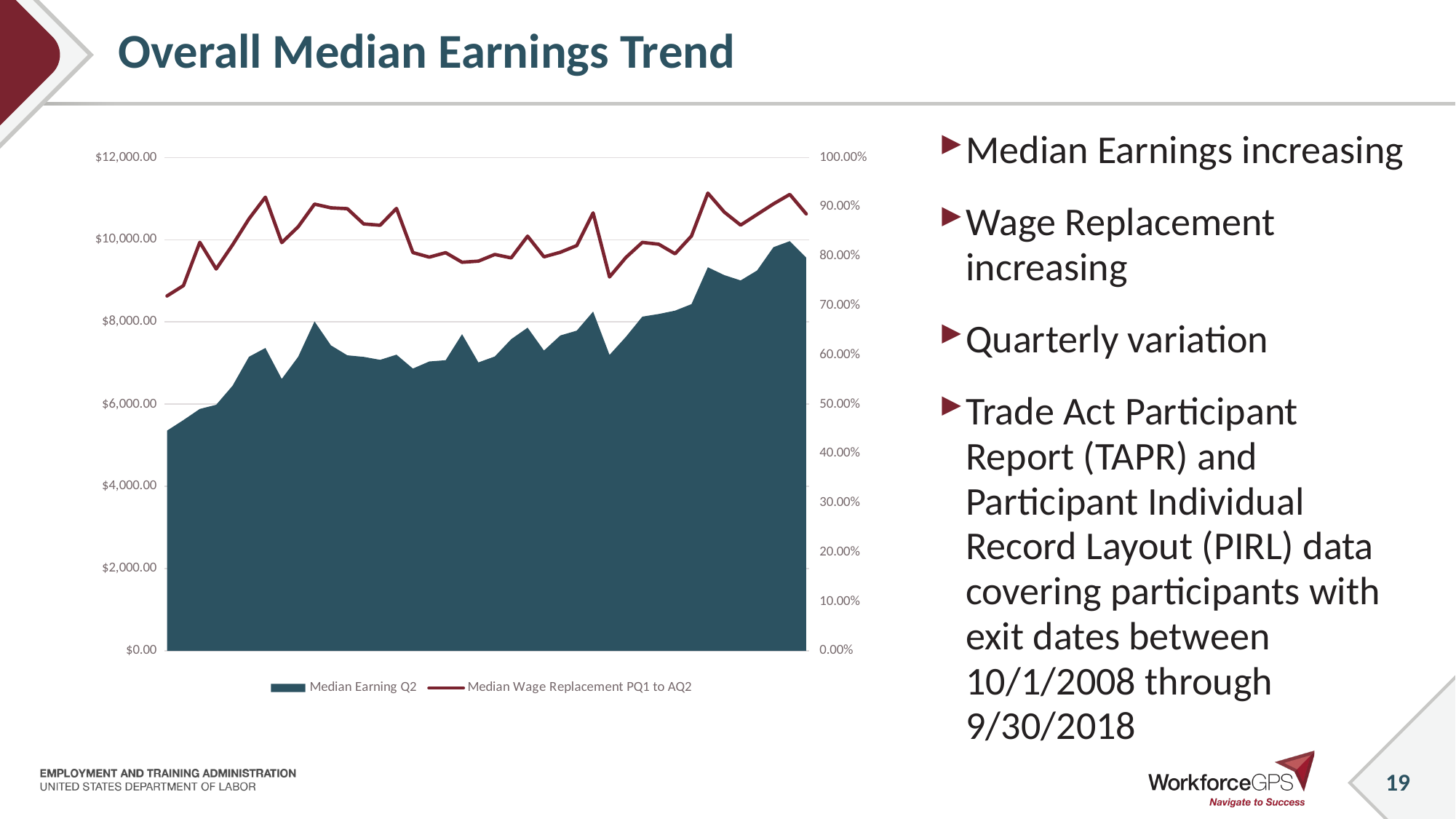
Which series is plotted as a shaded area rather than a line? Median Earning Q2 Is the last value of the Median Earning Q2 series greater or less than $8,000.00? greater Is the highest value of the Median Wage Replacement PQ1 to AQ2 series greater or less than 100.00%? less What kind of chart is shown on the slide? A combination chart with an area series and a line series Is the first value of the Median Earning Q2 series greater or less than $6,000.00? less What is the maximum value shown on the left vertical axis? $12,000.00 Does the Median Earning Q2 series generally rise or fall from left to right? Rise How many series does the chart legend list? 2